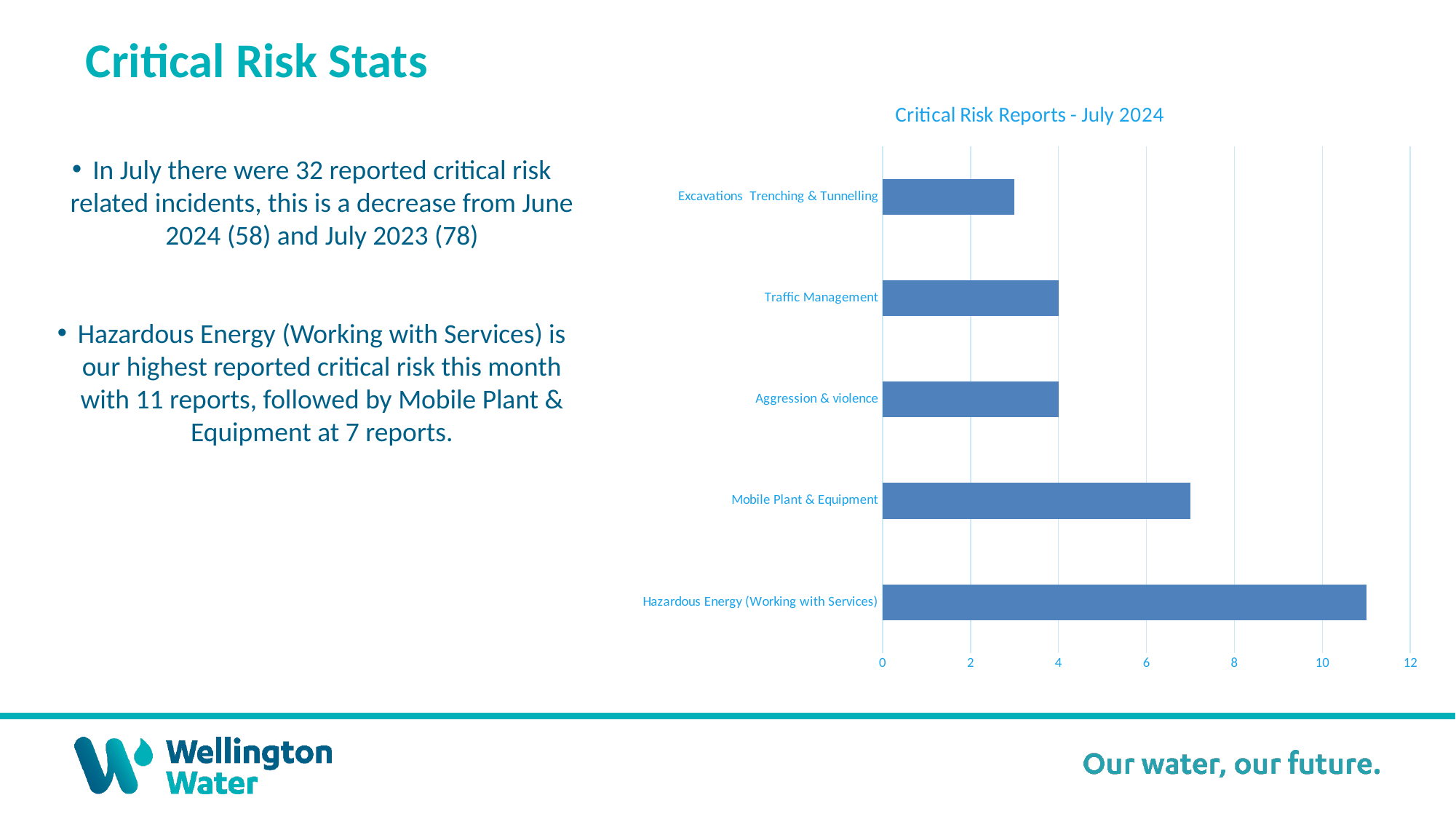
Which category has the lowest number of critical risk reports? Excavations Trenching & Tunnelling How many reports are shown for Traffic Management? 4 Which has more reports, Mobile Plant & Equipment or Traffic Management? Mobile Plant & Equipment How many reports are shown for Mobile Plant & Equipment? 7 Which category has the highest number of critical risk reports? Hazardous Energy (Working with Services) How many reports are shown for Hazardous Energy (Working with Services)? 11 Is the value for Excavations Trenching & Tunnelling greater or less than 2? greater What is the difference in reports between Hazardous Energy (Working with Services) and Mobile Plant & Equipment? 4 What kind of chart is shown on the slide? bar chart How many reports are shown for Aggression & violence? 4 How many categories are plotted in the chart? 5 What is the title of the chart? Critical Risk Reports - July 2024